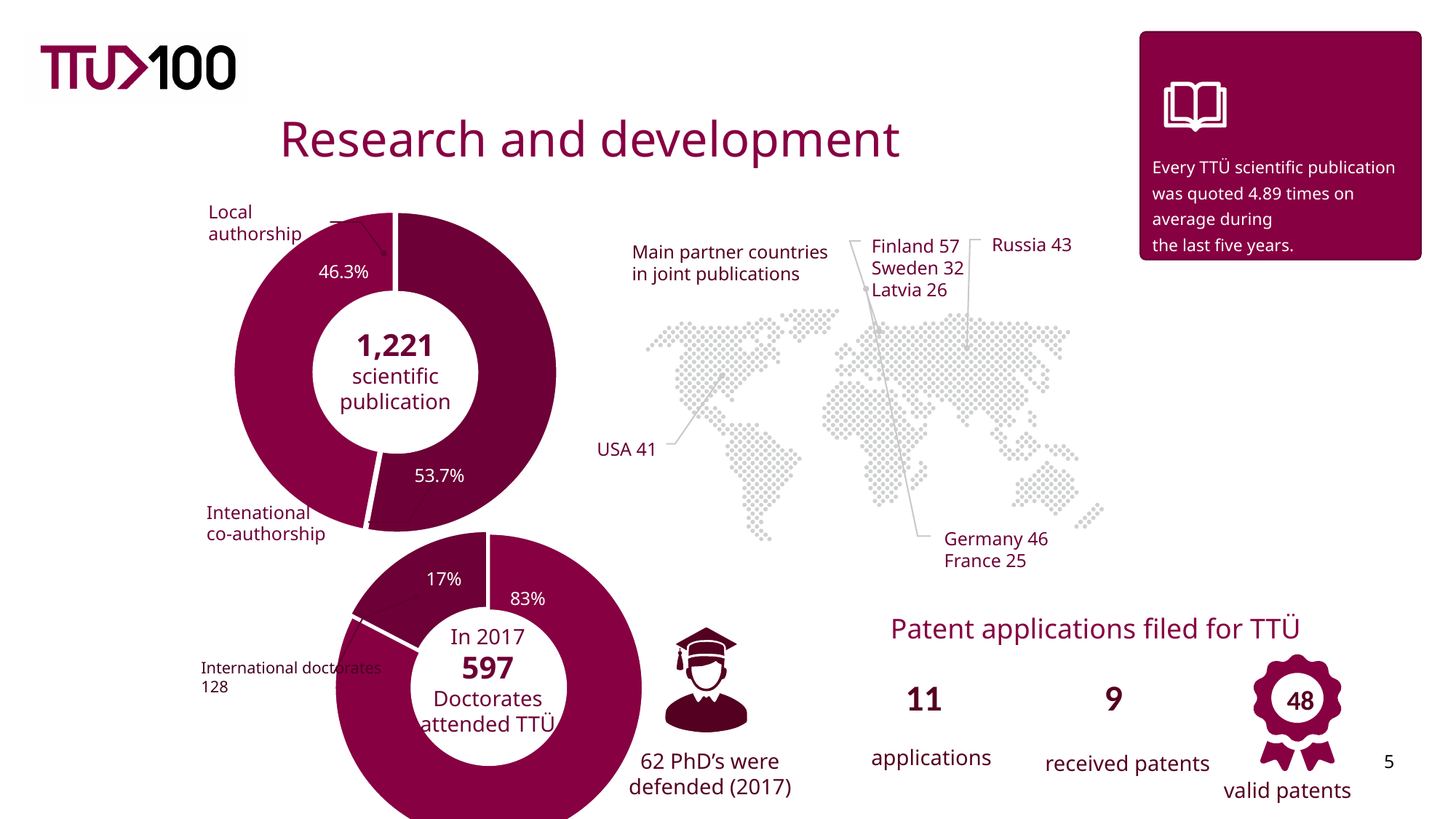
In the '597 Doctorates attended TTÜ' chart, what share is labelled on the larger slice? 83% In the '597 Doctorates attended TTÜ' chart, is the International doctorates slice larger or smaller than the other slice? smaller In the '597 Doctorates attended TTÜ' chart, what share is labelled for the International doctorates slice? 17% In the '1,221 scientific publication' chart, what share is labelled for Local authorship? 46.3% What total number is printed in the centre of the scientific publication chart? 1,221 What kind of chart is the '1,221 scientific publication' chart on the left of the slide? doughnut chart In the '1,221 scientific publication' chart, what is the difference in percentage points between International co-authorship and Local authorship? 7.4 percentage points In the '597 Doctorates attended TTÜ' chart, what is the difference in percentage points between the 83% slice and the 17% slice? 66 percentage points In the '1,221 scientific publication' chart, which category has the larger share? International co-authorship In the '1,221 scientific publication' chart, what share is labelled for International co-authorship? 53.7% In the '1,221 scientific publication' chart, how many categories are shown? 2 In the '597 Doctorates attended TTÜ' chart, how many International doctorates are stated? 128